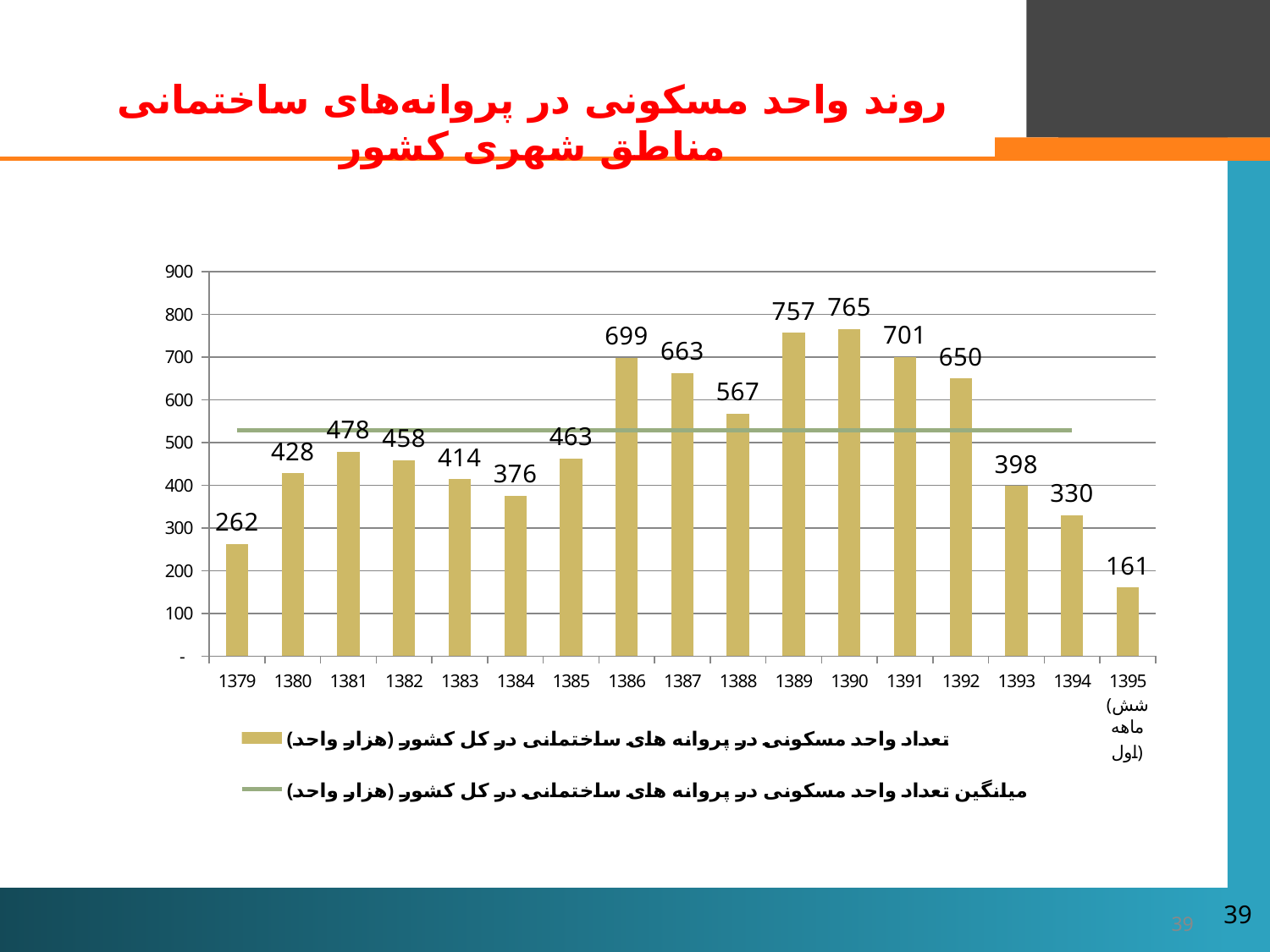
How many series does the legend list? 2 What is the value for 1395 (first six months)? 161 What is the value for 1390? 765 How many years (categories) are shown on the x axis? 17 Do the values rise or fall from 1392 to 1395? fall Which is larger, the value for 1381 or the value for 1382? 1381 Is the average line (green) greater or less than 500? greater Which category has the lowest bar? 1395 What kind of chart is this? combination bar and line chart What is the difference between the values for 1389 and 1388? 190 What is the value for 1379? 262 Which year has the highest bar? 1390